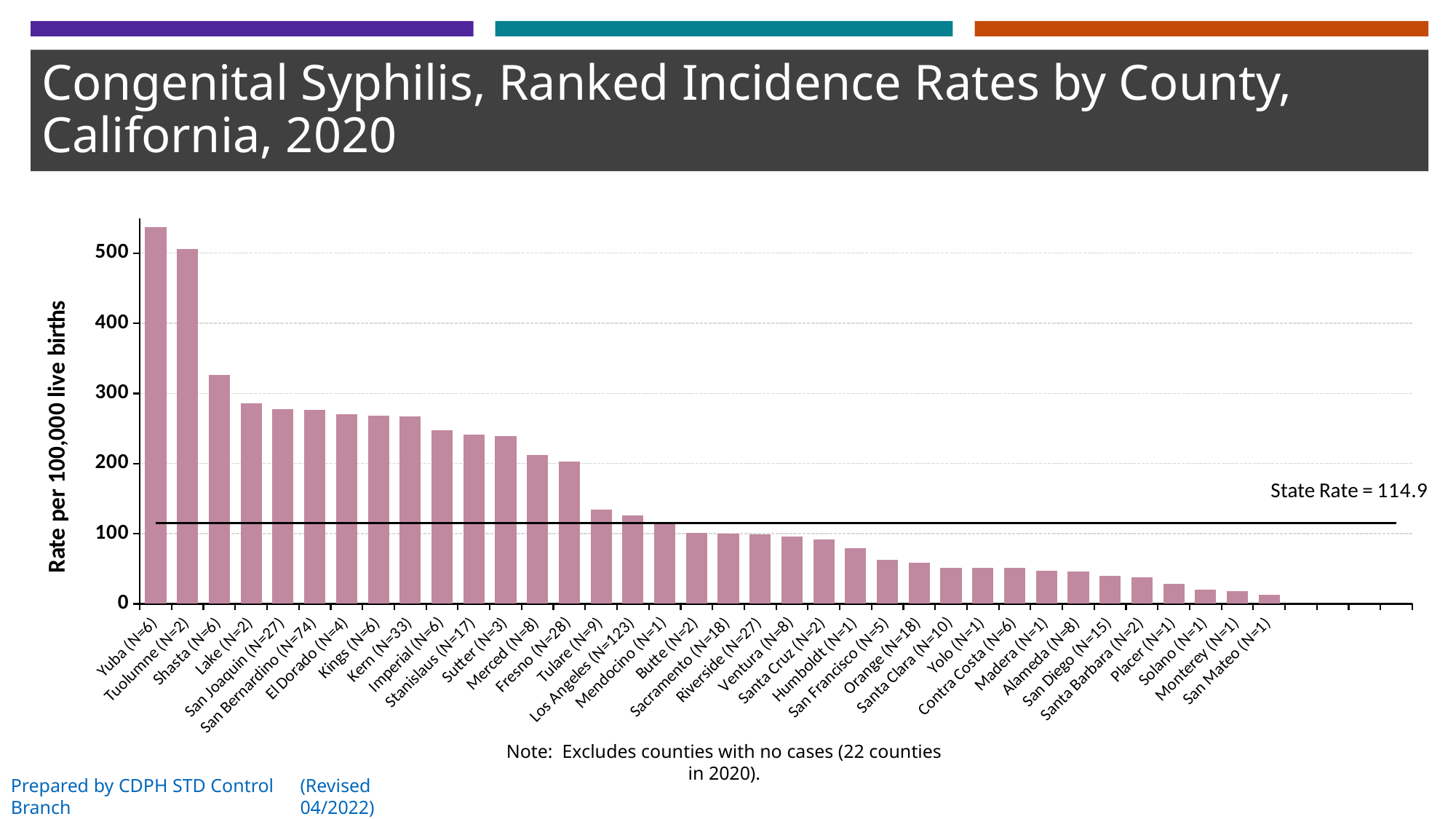
How many counties are shown on the chart? 36 Which county has the lowest congenital syphilis incidence rate shown? San Mateo Is the value for Yuba greater or less than 500? greater Which county has a higher rate, Tuolumne or Lake? Tuolumne Do the values rise or fall moving from left to right along the x axis? fall Is the value for Los Angeles greater or less than 200? less What is the state rate shown on the chart? 114.9 What kind of chart is shown on the slide? bar chart Which county has the highest congenital syphilis incidence rate? Yuba Is the value for Fresno greater or less than 300? less What is the label on the vertical axis? Rate per 100,000 live births